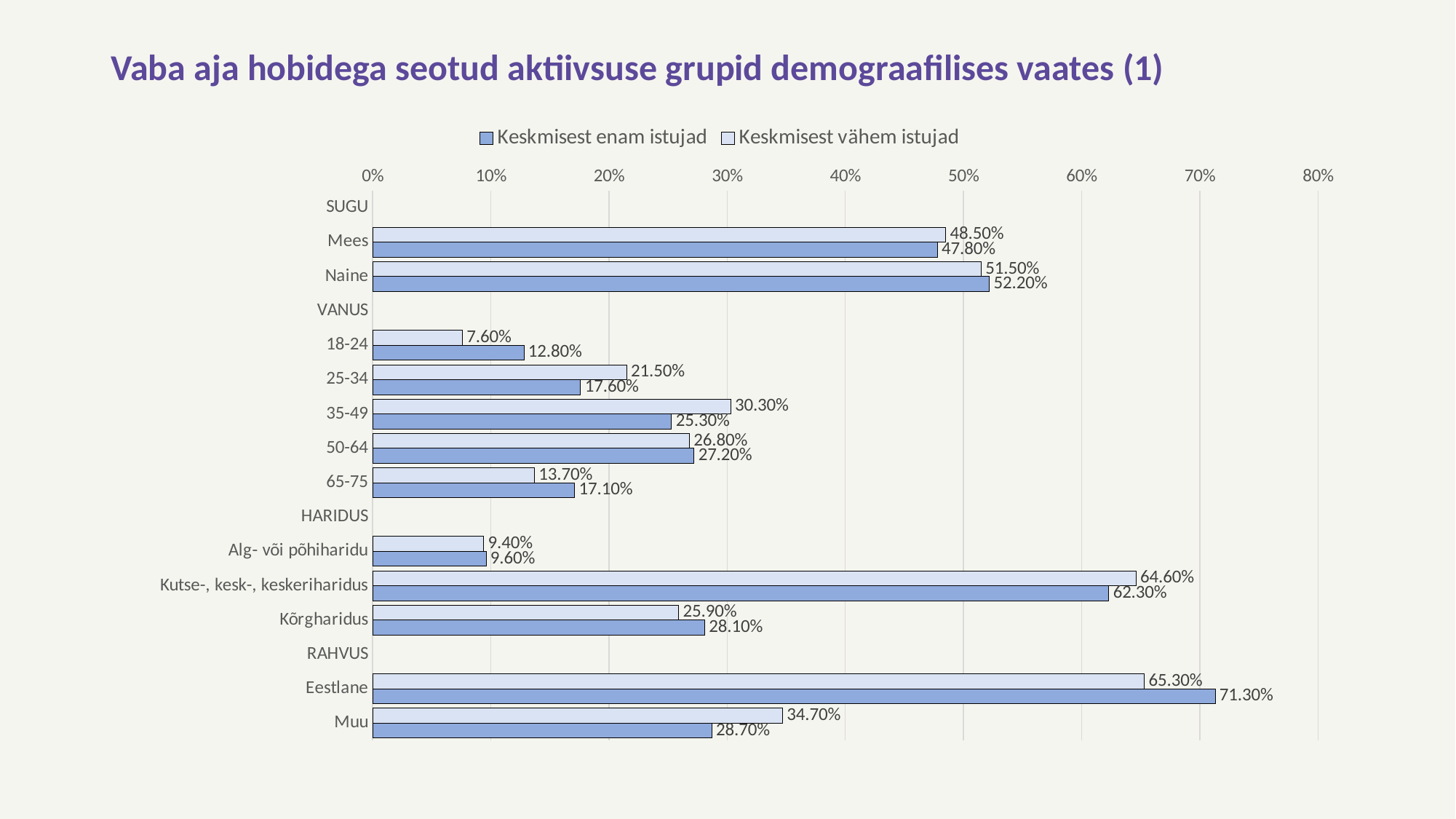
Is the value for Naine in the Keskmisest enam istujad series greater or less than 50%? greater What is the title of the chart? Vaba aja hobidega seotud aktiivsuse grupid demograafilises vaates (1) Which category has the lowest value in the Keskmisest vähem istujad series? 18-24 What is the value for Kutse-, kesk-, keskeriharidus in the Keskmisest vähem istujad series? 64.60% What kind of chart is shown on the slide? bar chart What is the difference between the Keskmisest enam istujad and Keskmisest vähem istujad values for Muu? 6.00% Which category has the highest value in the Keskmisest enam istujad series? Eestlane What is the value for Eestlane in the Keskmisest enam istujad series? 71.30% For 35-49, which series has the larger value: Keskmisest enam istujad or Keskmisest vähem istujad? Keskmisest vähem istujad What is the difference between the Keskmisest enam istujad values for Eestlane and Muu? 42.60% How many series does the legend list? 2 What is the value for 18-24 in the Keskmisest vähem istujad series? 7.60%